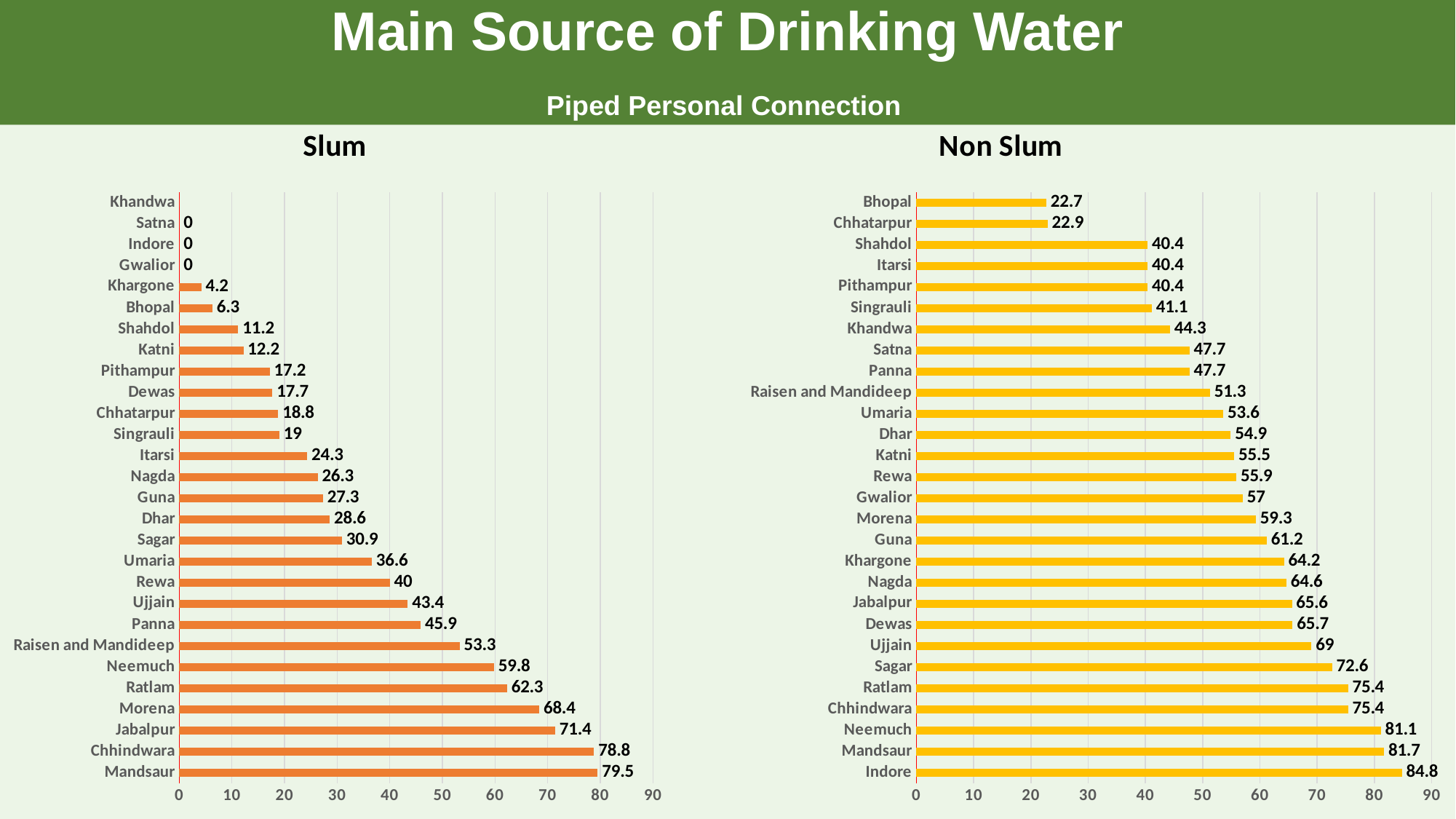
In the Non Slum chart, which city has the highest value? Indore How many cities are listed in the Non Slum chart? 28 In the Non Slum chart, what is the difference between the values for Indore and Bhopal? 62.1 In the Non Slum chart, which city has the lowest value? Bhopal In the Slum chart, what is the value for Mandsaur? 79.5 In the Non Slum chart, what is the value for Ujjain? 69 In the Slum chart, is the value for Neemuch greater or less than 50? greater What is the subtitle shown below the main title of the slide? Piped Personal Connection In the Slum chart, which city has the highest value? Mandsaur What type of chart is the Slum chart? Bar chart Is the value for Morena larger in the Slum chart or the Non Slum chart? Slum In the Slum chart, what is the value for Raisen and Mandideep? 53.3